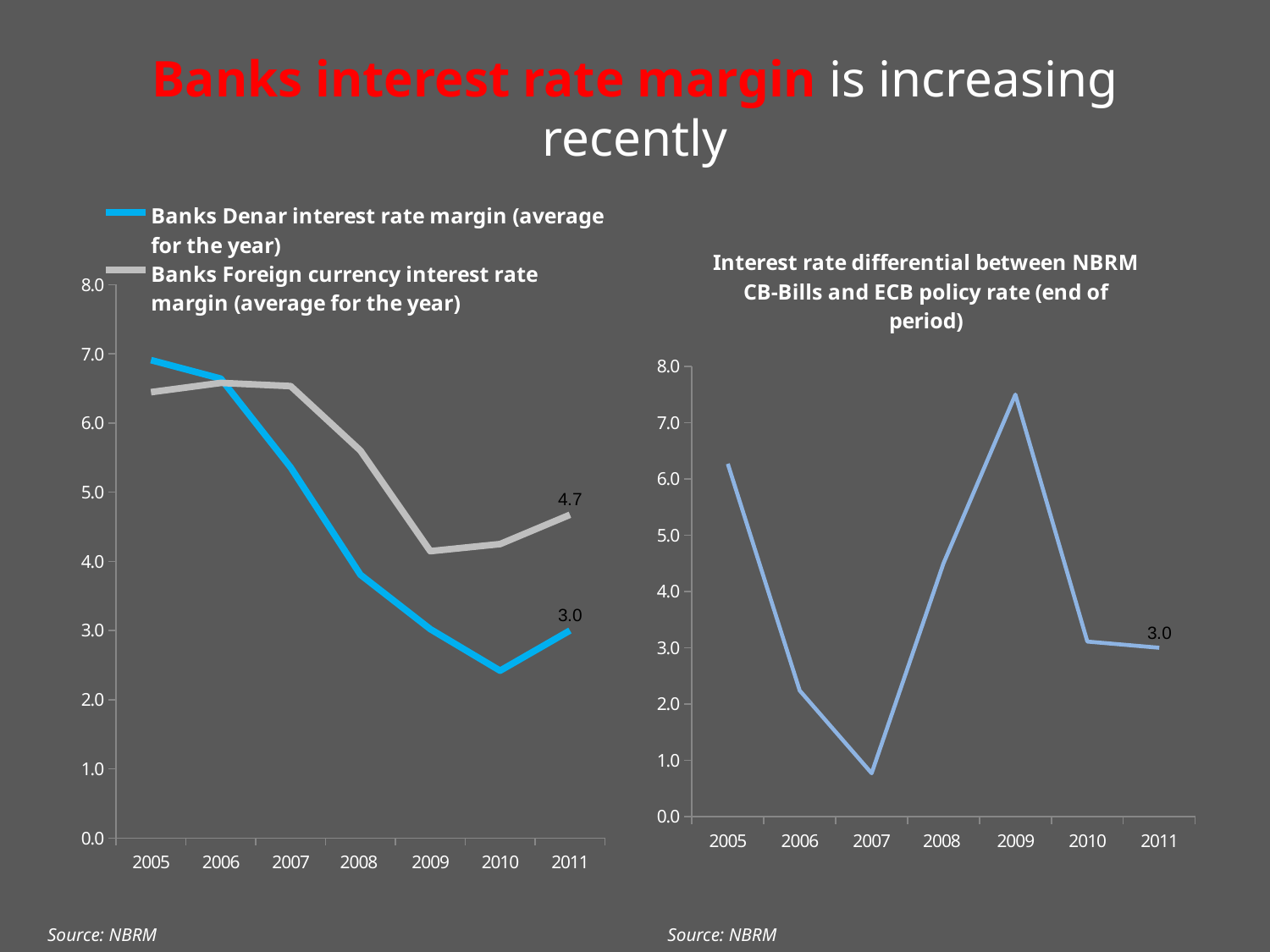
In the chart titled 'Interest rate differential between NBRM CB-Bills and ECB policy rate (end of period)', is the value for 2007 greater or less than 1.0? less In the left chart, is the Banks Denar interest rate margin in 2005 greater or less than 6.0? greater In the left chart, what is the difference between the Foreign currency and Denar interest rate margins in 2011? 1.7 How many series does the legend of the left chart list? 2 In the chart titled 'Interest rate differential between NBRM CB-Bills and ECB policy rate (end of period)', which year has the highest value? 2009 In the left chart, which series has the higher value in 2011, the Denar margin or the Foreign currency margin? Banks Foreign currency interest rate margin In the chart titled 'Interest rate differential between NBRM CB-Bills and ECB policy rate (end of period)', which year has the lowest value? 2007 What kind of chart is the chart titled 'Interest rate differential between NBRM CB-Bills and ECB policy rate (end of period)'? line chart In the left chart, is the Banks Denar interest rate margin in 2010 greater or less than 3.0? less In the left chart, what is the value of the Banks Foreign currency interest rate margin in 2011? 4.7 In the left chart, what is the value of the Banks Denar interest rate margin in 2011? 3.0 In the chart titled 'Interest rate differential between NBRM CB-Bills and ECB policy rate (end of period)', what is the value for 2011? 3.0